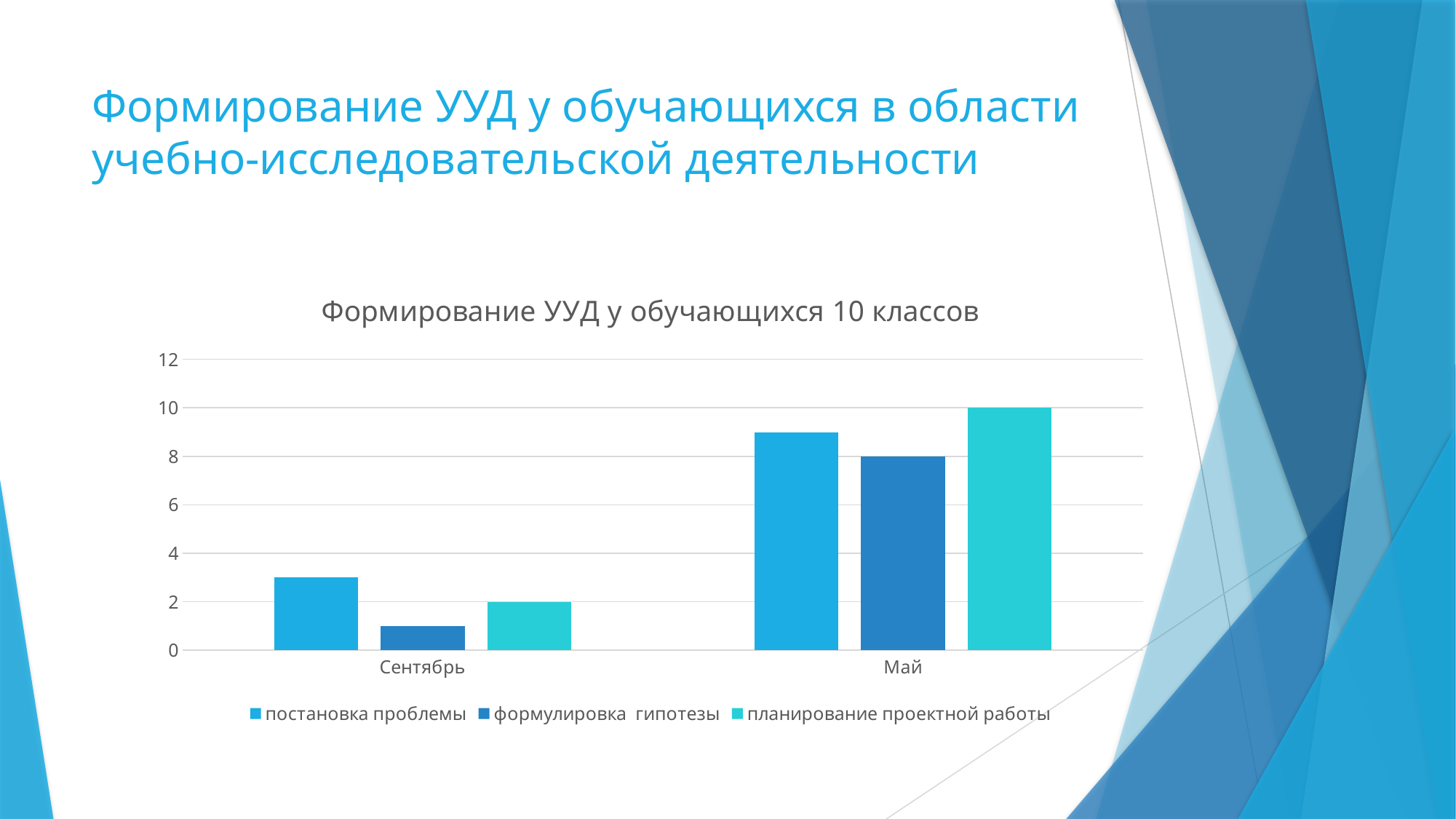
Which series has the highest value in Май? планирование проектной работы Is the value for постановка проблемы in Сентябрь greater or less than 4? less How many series does the legend list? 3 Which series has the lowest value in Сентябрь? формулировка гипотезы What is the value for формулировка гипотезы in Май? 8 What is the title of the chart? Формирование УУД у обучающихся 10 классов Do the values for постановка проблемы rise or fall from Сентябрь to Май? rise What is the value for планирование проектной работы in Сентябрь? 2 What kind of chart is shown on the slide? bar chart How many categories are shown on the x axis? 2 What is the value for планирование проектной работы in Май? 10 Is the value for постановка проблемы in Май greater or less than 8? greater